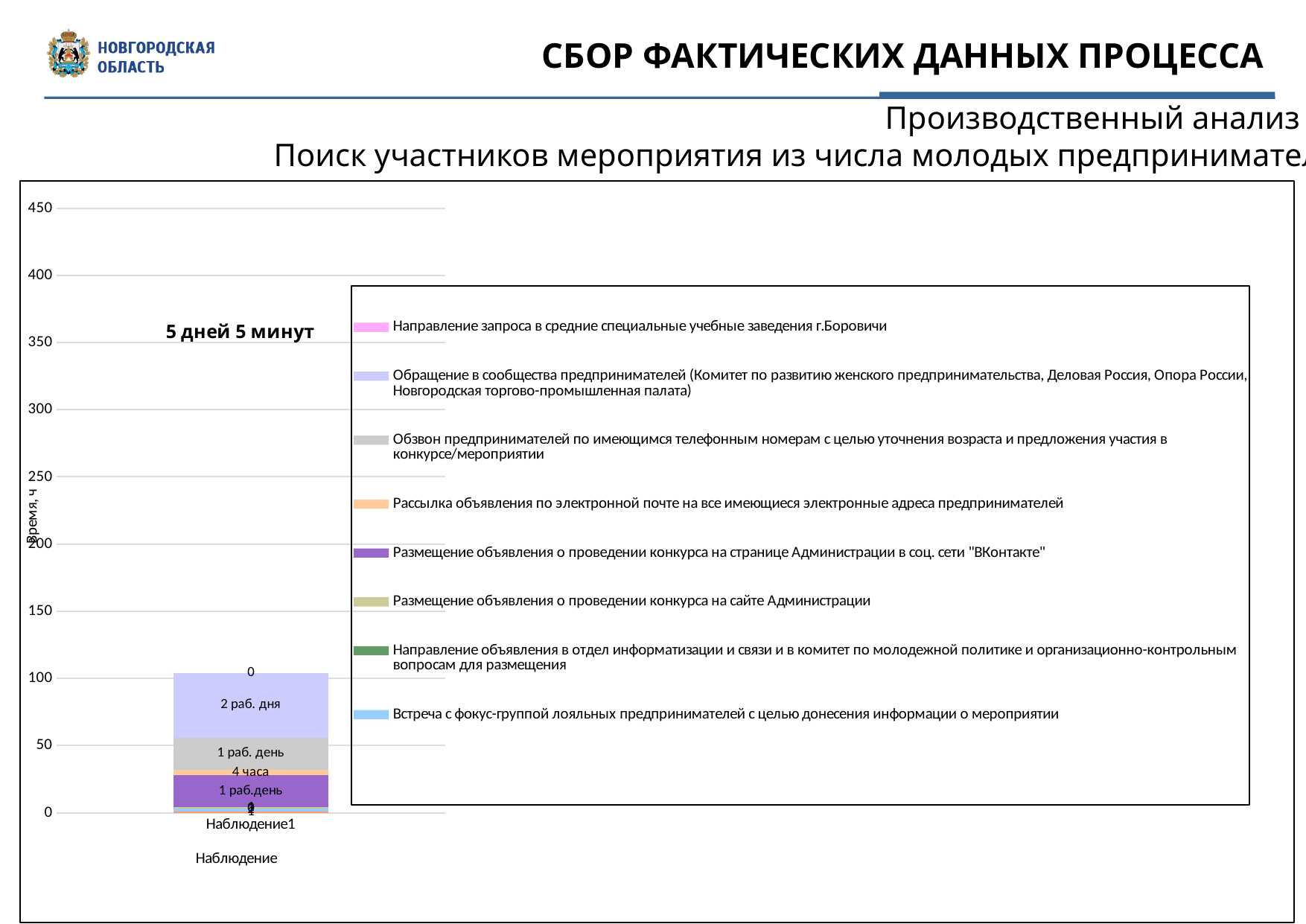
How many categories are plotted on the x axis? 1 What is the label of the single category on the x axis? Наблюдение1 What is the title of the vertical axis? Время, ч What data label is shown on the segment for "Размещение объявления о проведении конкурса на странице Администрации в соц. сети "ВКонтакте""? 1 раб.день What data label is shown on the segment for "Обращение в сообщества предпринимателей"? 2 раб. дня What kind of chart is shown on the slide? Stacked bar chart What data label is shown on the segment for "Рассылка объявления по электронной почте"? 4 часа What total duration is written above the stacked bar? 5 дней 5 минут How many series does the legend list? 8 Which series has the largest segment in the stacked bar? Обращение в сообщества предпринимателей Is the top of the stacked bar for Наблюдение1 greater or less than 50 on the vertical axis? greater What data label is shown on the segment for "Обзвон предпринимателей по имеющимся телефонным номерам"? 1 раб. день